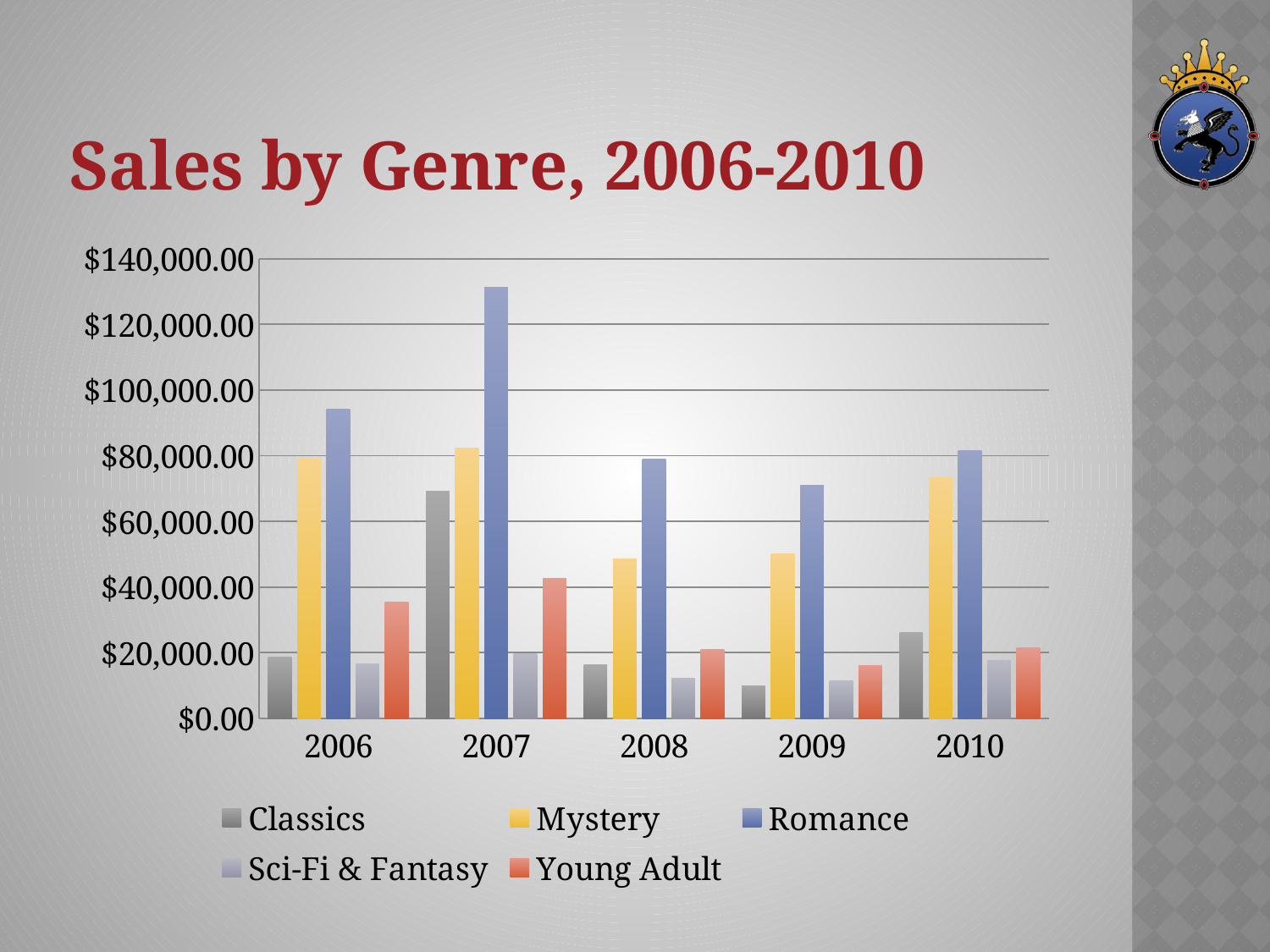
In 2008, which is larger: Sci-Fi & Fantasy or Young Adult? Young Adult What is the title of the chart? Sales by Genre, 2006-2010 Is the value for Classics in 2007 greater or less than $60,000.00? greater How many years are shown on the x axis? 5 Is the value for Young Adult in 2009 greater or less than $20,000.00? less Do the Romance values rise or fall from 2007 to 2009? fall Is the value for Romance in 2007 greater or less than $120,000.00? greater In which year is the Romance bar the highest? 2007 In which year is the Classics bar the lowest? 2009 How many series does the legend list? 5 What kind of chart is shown on the slide? bar chart In 2006, which is larger: Mystery or Romance? Romance